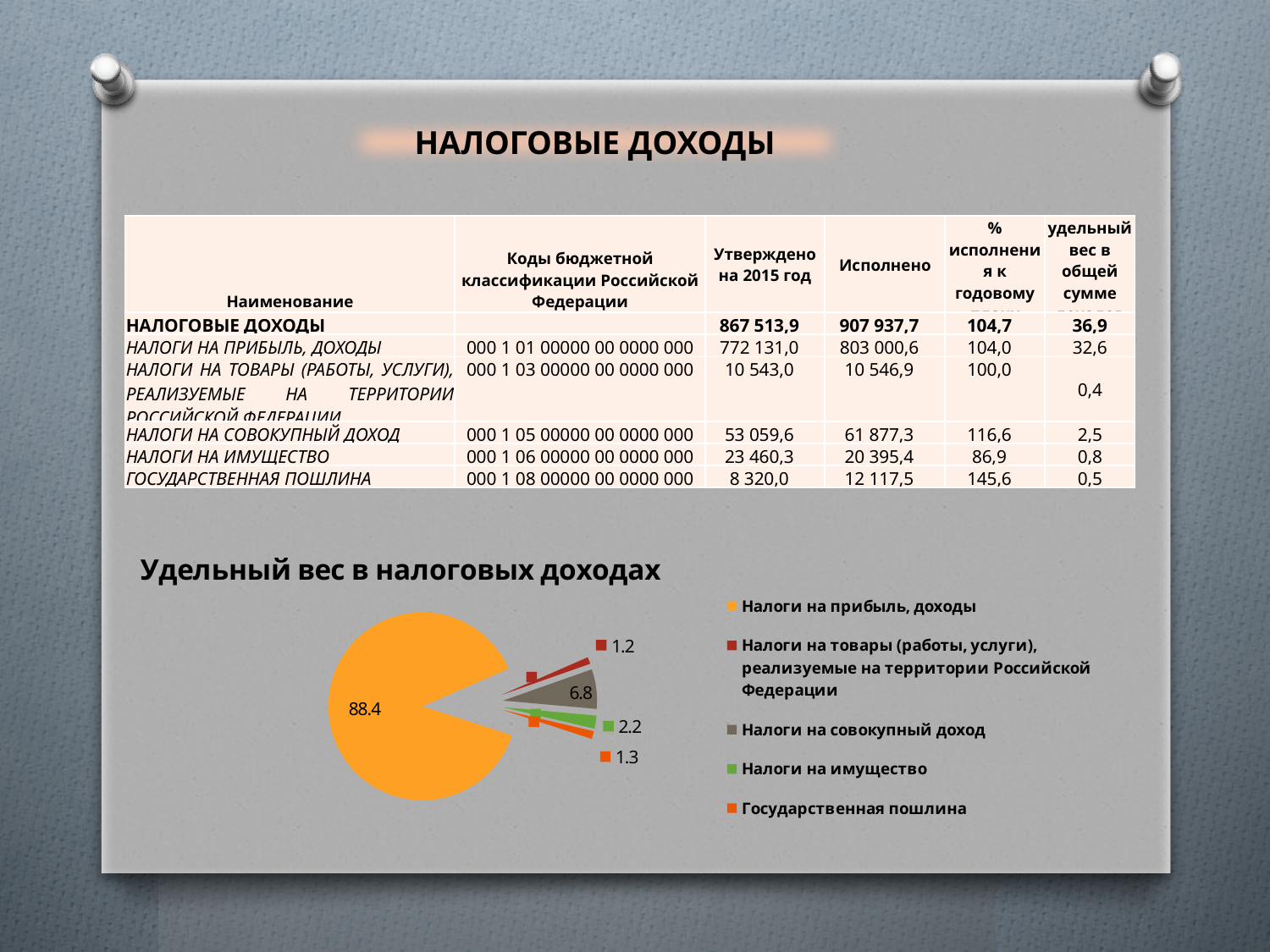
What kind of chart is shown under the heading "Удельный вес в налоговых доходах"? pie chart What is the title of the pie chart? Удельный вес в налоговых доходах How many categories does the legend of the pie chart list? 5 In the pie chart, what is the value for "Налоги на имущество"? 2.2 In the pie chart, which is larger: "Налоги на имущество" or "Государственная пошлина"? Налоги на имущество Which category has the largest slice in the pie chart? Налоги на прибыль, доходы In the pie chart, what is the value for "Налоги на товары (работы, услуги), реализуемые на территории Российской Федерации"? 1.2 Which category has the smallest slice in the pie chart? Налоги на товары (работы, услуги), реализуемые на территории Российской Федерации In the pie chart, what is the difference between the values for "Налоги на совокупный доход" and "Налоги на имущество"? 4.6 In the pie chart, what is the value for "Налоги на прибыль, доходы"? 88.4 In the pie chart, what is the value for "Государственная пошлина"? 1.3 In the pie chart, what is the value for "Налоги на совокупный доход"? 6.8